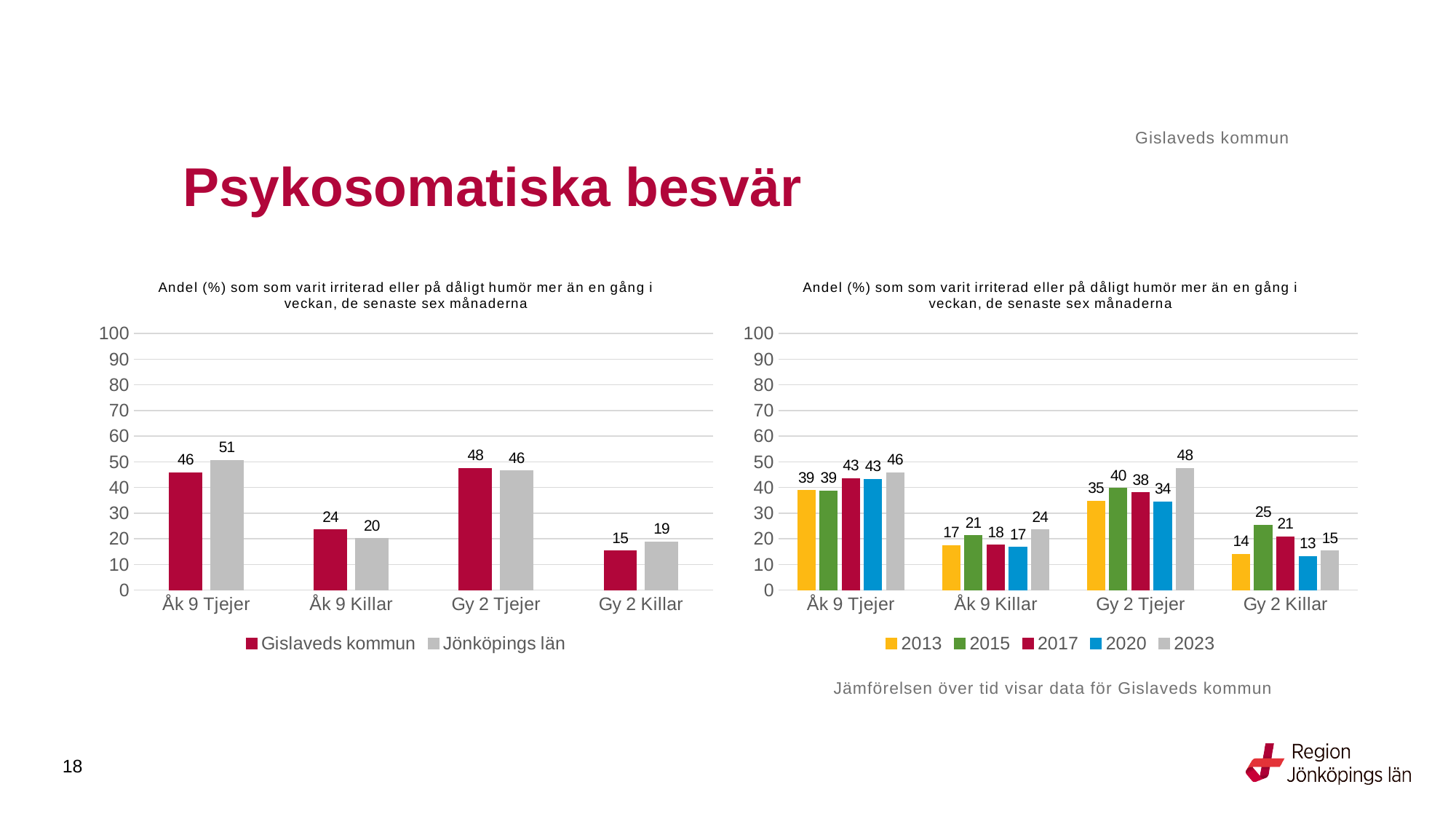
In the left chart, what is the value for Gislaveds kommun for Åk 9 Killar? 24 In the right chart, what is the value for 2023 for Gy 2 Tjejer? 48 In the left chart, which category has the highest value for Jönköpings län? Åk 9 Tjejer In the right chart, what is the value for 2013 for Gy 2 Killar? 14 In the left chart, what is the value for Jönköpings län for Gy 2 Killar? 19 In the right chart, which is larger for Gy 2 Killar: the value for 2015 or the value for 2020? 2015 In the left chart, how many series does the legend list? 2 In the right chart, which year has the highest value for Åk 9 Killar? 2023 In the right chart, how many series does the legend list? 5 What kind of chart is the right chart? Bar chart In the left chart, which category has the lowest value for Gislaveds kommun? Gy 2 Killar In the left chart, what is the difference between Jönköpings län and Gislaveds kommun for Åk 9 Tjejer? 5